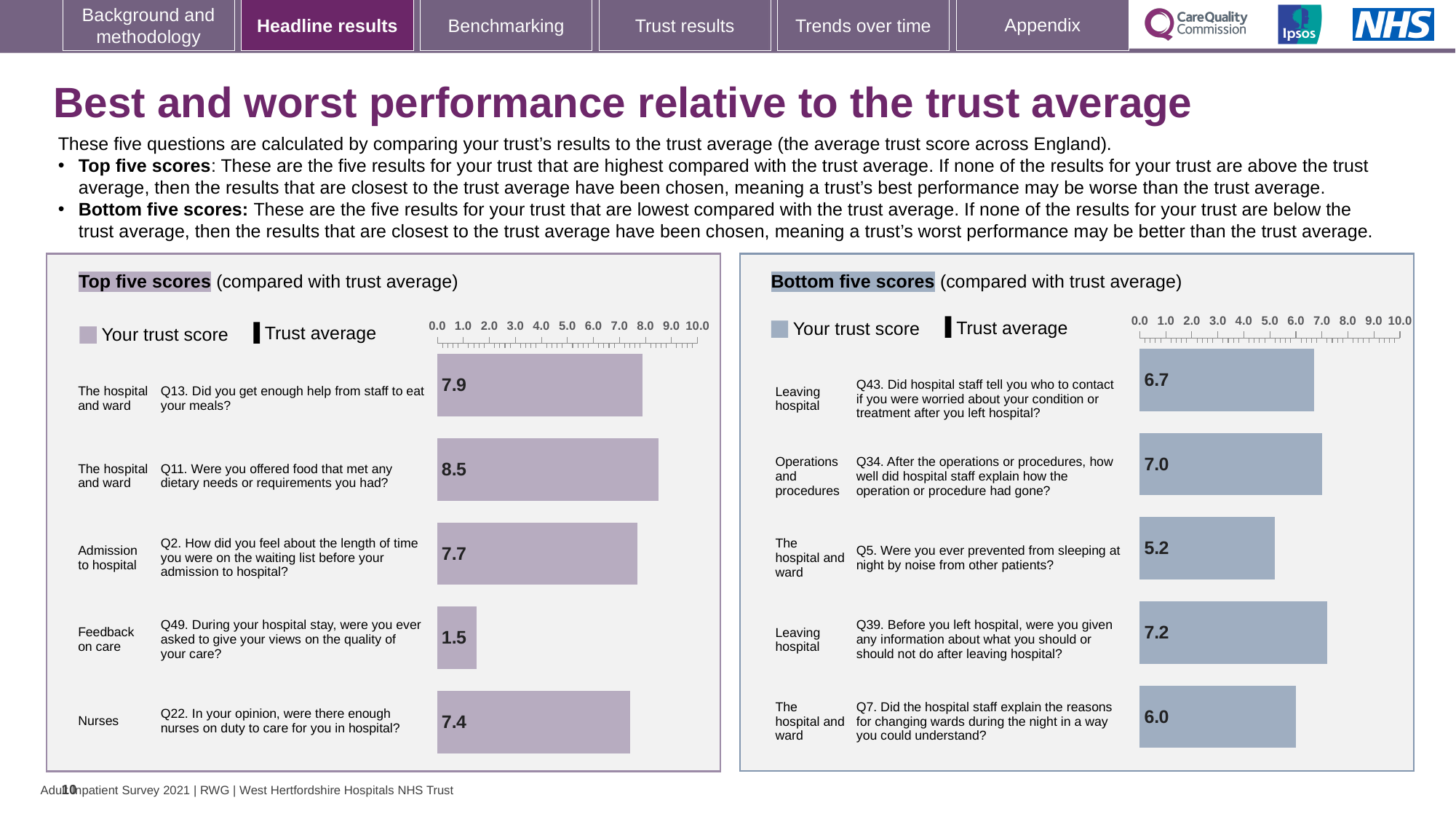
In the Bottom five scores chart, what is the trust score for Q5 (Were you ever prevented from sleeping at night by noise from other patients?)? 5.2 In the Top five scores chart, which question has the lowest trust score? Q49 (1.5) In the Bottom five scores chart, what is the difference between the scores for Q34 and Q7? 1.0 What type of chart is used in the Bottom five scores panel? Bar chart In the Top five scores chart, which question has the highest trust score? Q11 (8.5) How many questions are plotted in the Top five scores chart? 5 In the Top five scores chart, which has the larger score: Q2 or Q22? Q2 In the Top five scores chart, what is the trust score for Q49 (were you ever asked to give your views on the quality of your care?)? 1.5 In the Top five scores chart, what is the trust score for Q13 (Did you get enough help from staff to eat your meals?)? 7.9 In the Bottom five scores chart, what is the trust score for Q39? 7.2 In the Bottom five scores chart, which question has the lowest trust score? Q5 (5.2) In the Top five scores chart, what is the difference between the scores for Q11 and Q13? 0.6